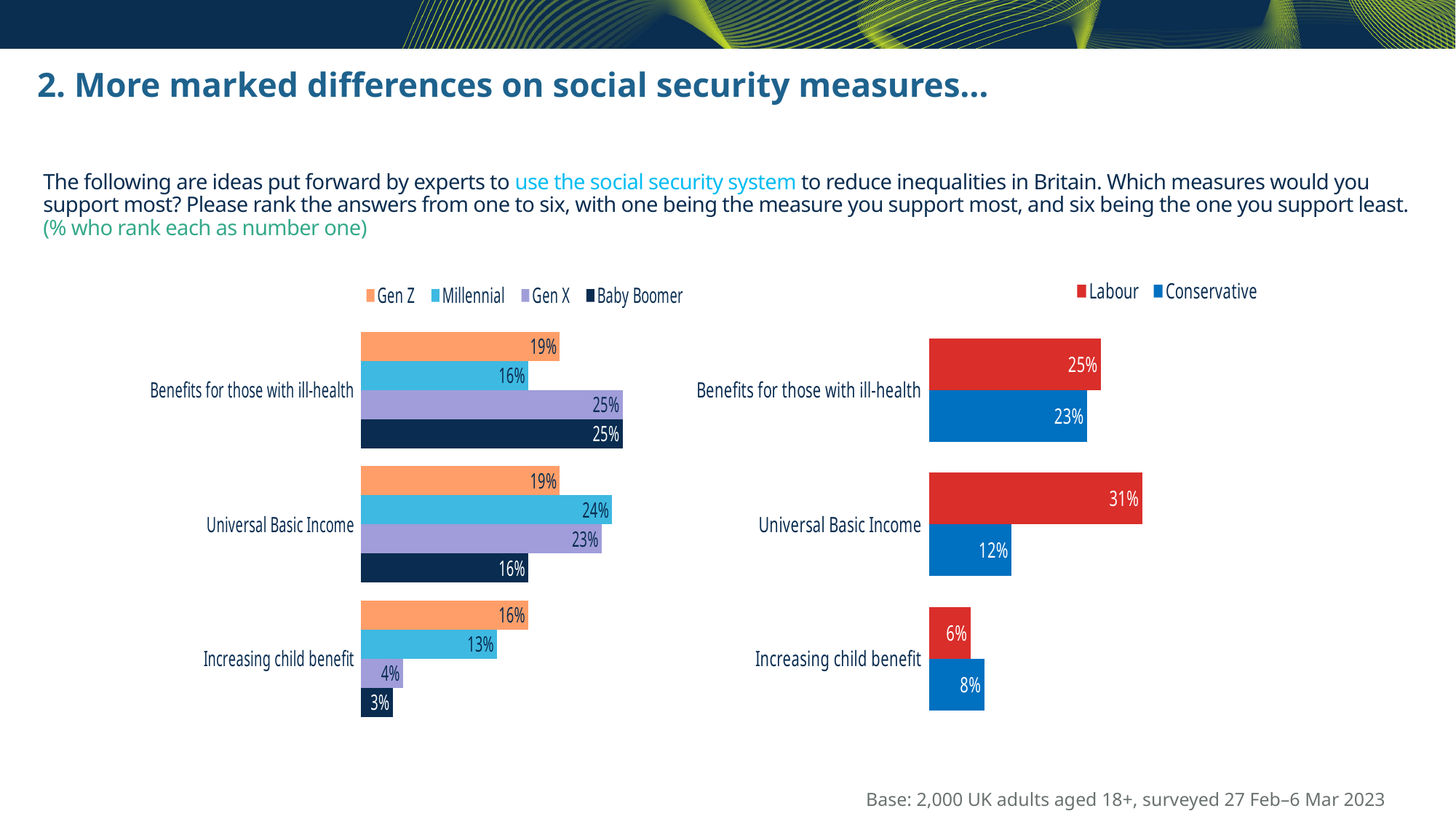
How many measures (categories) are shown in the right chart (parties)? 3 In the left chart (generations), which generation has the lowest value for Increasing child benefit? Baby Boomer In the left chart (generations), what is the difference between the Gen Z and Gen X values for Increasing child benefit? 12 percentage points In the right chart (parties), which is larger for Increasing child benefit: the Labour value or the Conservative value? Conservative How many series does the legend of the left chart (generations) list? 4 In the left chart (generations), what percentage of Gen X rank Benefits for those with ill-health as number one? 25% In the left chart (generations), what percentage of Millennials rank Universal Basic Income as number one? 24% In the right chart (parties), what is the difference between the Labour and Conservative values for Universal Basic Income? 19 percentage points What kind of chart is the left chart (generations)? Bar chart In the right chart (parties), what percentage of Labour supporters rank Universal Basic Income as number one? 31% In the right chart (parties), what percentage of Conservative supporters rank Increasing child benefit as number one? 8% In the right chart (parties), which measure has the highest Labour value? Universal Basic Income